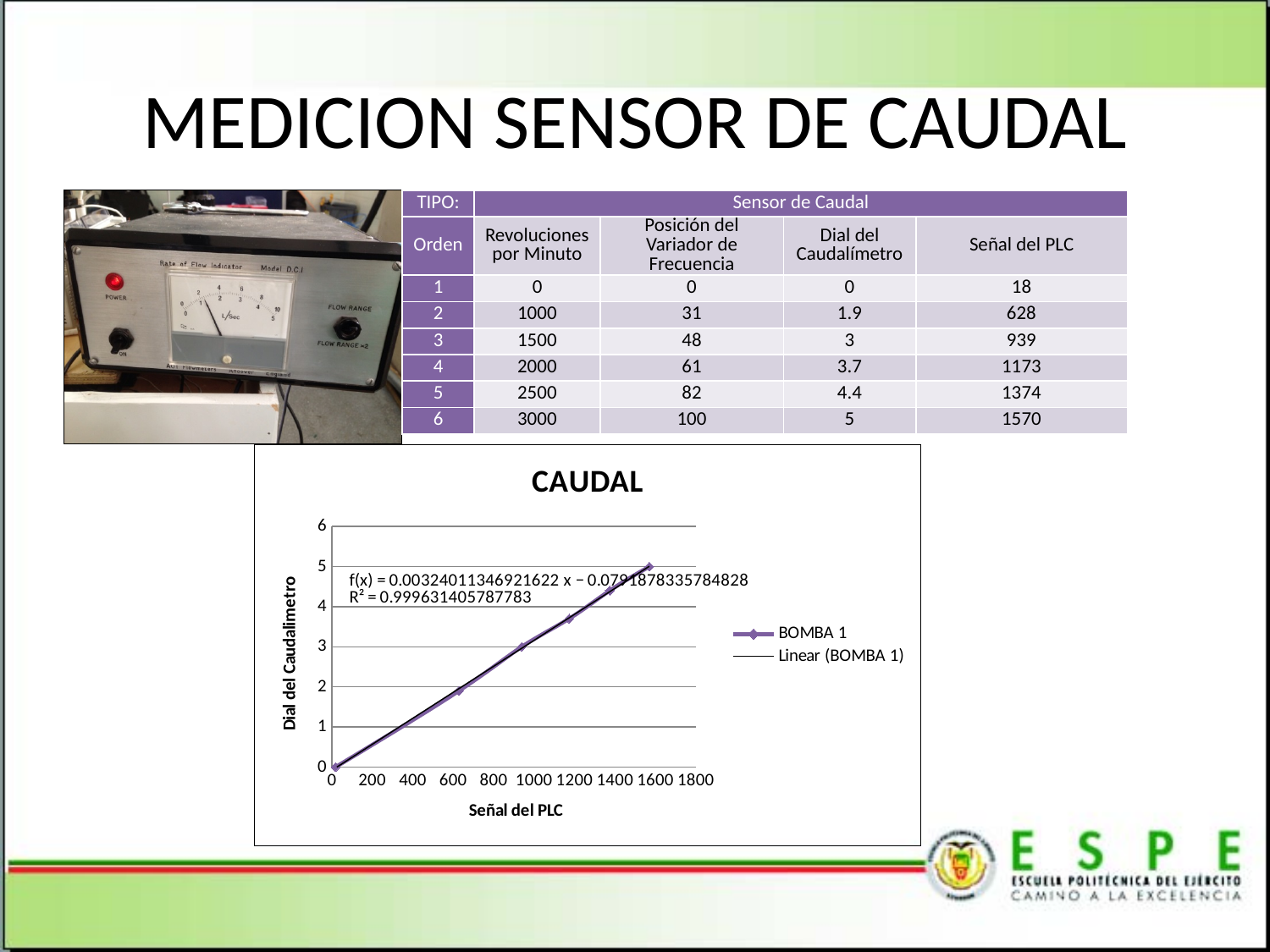
In the CAUDAL chart, what is the Dial del Caudalímetro value when the Señal del PLC is 1374? 4.4 What R² value is shown on the CAUDAL chart? 0.999631405787783 In the CAUDAL chart, is the Dial del Caudalimetro value at a Señal del PLC of 939 greater or less than 2? greater In the CAUDAL chart, is the Dial del Caudalimetro value at a Señal del PLC of 1570 greater or less than 4? greater In the CAUDAL chart, at which Señal del PLC value is the Dial del Caudalímetro highest? 1570 In the CAUDAL chart, does the Dial del Caudalimetro rise or fall as Señal del PLC increases? rises How many series does the legend of the CAUDAL chart list? 2 What is the title of the chart on the slide? CAUDAL What is the first entry in the legend of the CAUDAL chart? BOMBA 1 In the CAUDAL chart, is the Dial del Caudalimetro value at a Señal del PLC of 1173 greater or less than 3? greater How many data points are plotted for BOMBA 1 in the CAUDAL chart? 6 What kind of chart is the CAUDAL chart? line chart